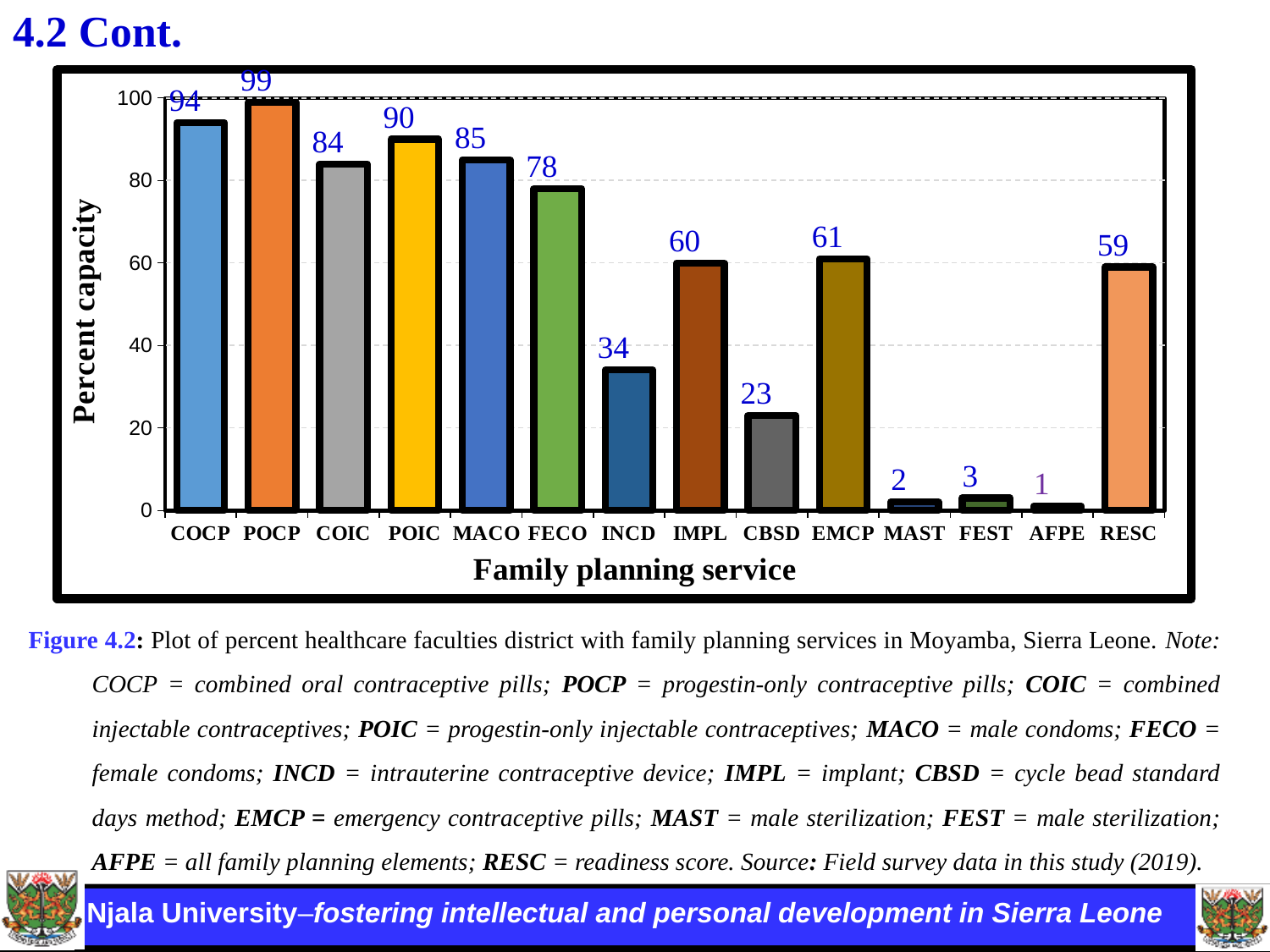
What is the percent capacity for RESC? 59 What is the percent capacity for POCP? 99 Which family planning service has the lowest percent capacity? AFPE How many family planning services are shown on the x axis? 14 What is the label of the y axis? Percent capacity What is the difference in percent capacity between COCP and CBSD? 71 Which family planning service has the highest percent capacity? POCP Which has a higher percent capacity, IMPL or EMCP? EMCP What kind of chart is shown on the slide? bar chart What is the label of the x axis? Family planning service Is the value for FECO greater or less than 80? less What is the percent capacity for INCD? 34